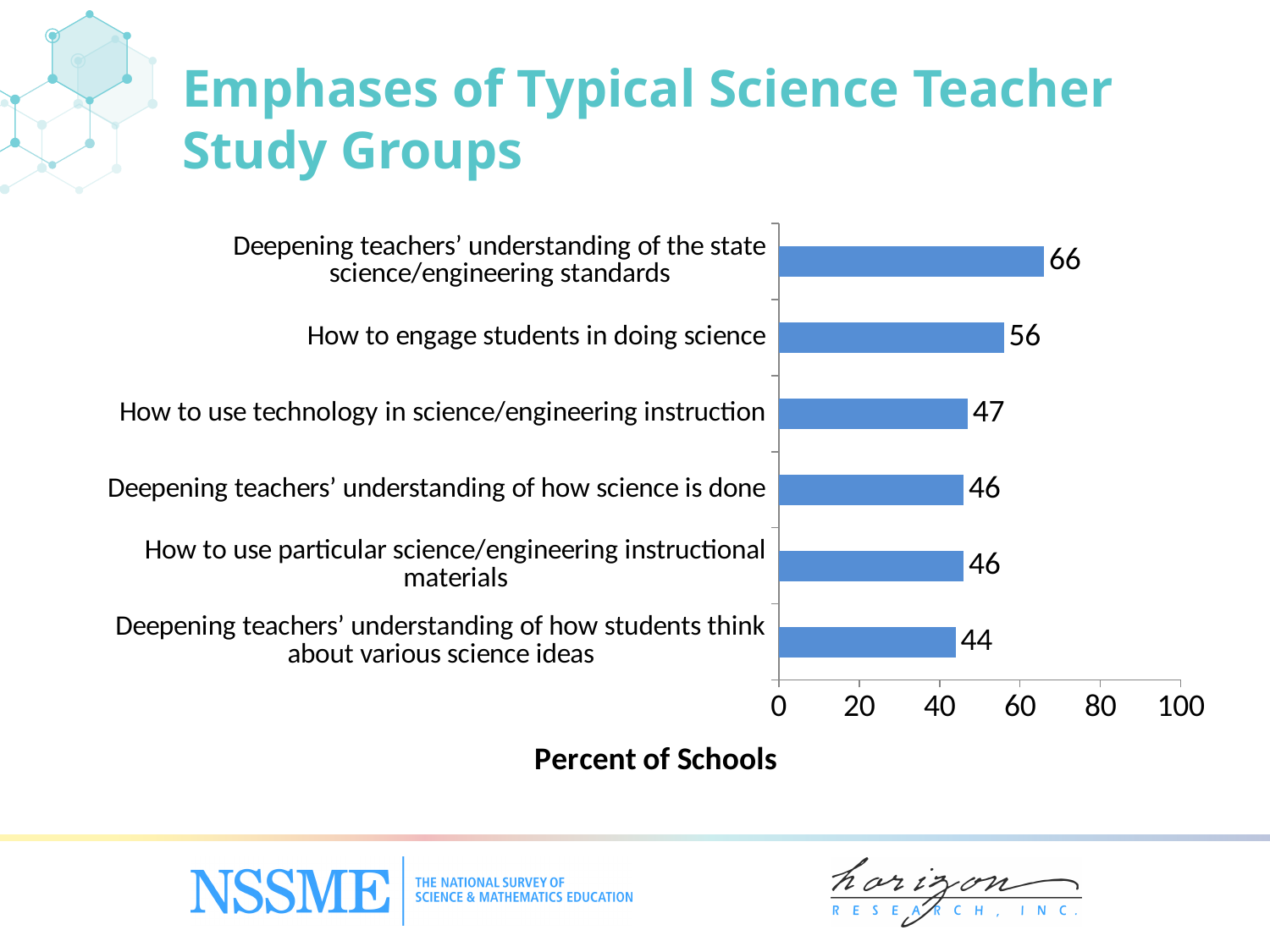
What kind of chart is shown on the slide? Bar chart Is the value for 'Deepening teachers' understanding of how science is done' greater or less than 60? less Which emphasis has the highest percent of schools? Deepening teachers' understanding of the state science/engineering standards What is the value for 'How to use technology in science/engineering instruction'? 47 Which is larger: the value for 'How to engage students in doing science' or 'How to use technology in science/engineering instruction'? How to engage students in doing science Which emphasis has the lowest percent of schools? Deepening teachers' understanding of how students think about various science ideas What is the difference between the values for deepening teachers' understanding of the state science/engineering standards and how to engage students in doing science? 10 What is the value for 'Deepening teachers' understanding of how students think about various science ideas'? 44 What is the value for 'How to engage students in doing science'? 56 How many emphases (categories) are shown in the chart? 6 What is the label of the horizontal axis? Percent of Schools What percent of schools report study groups emphasizing deepening teachers' understanding of the state science/engineering standards? 66